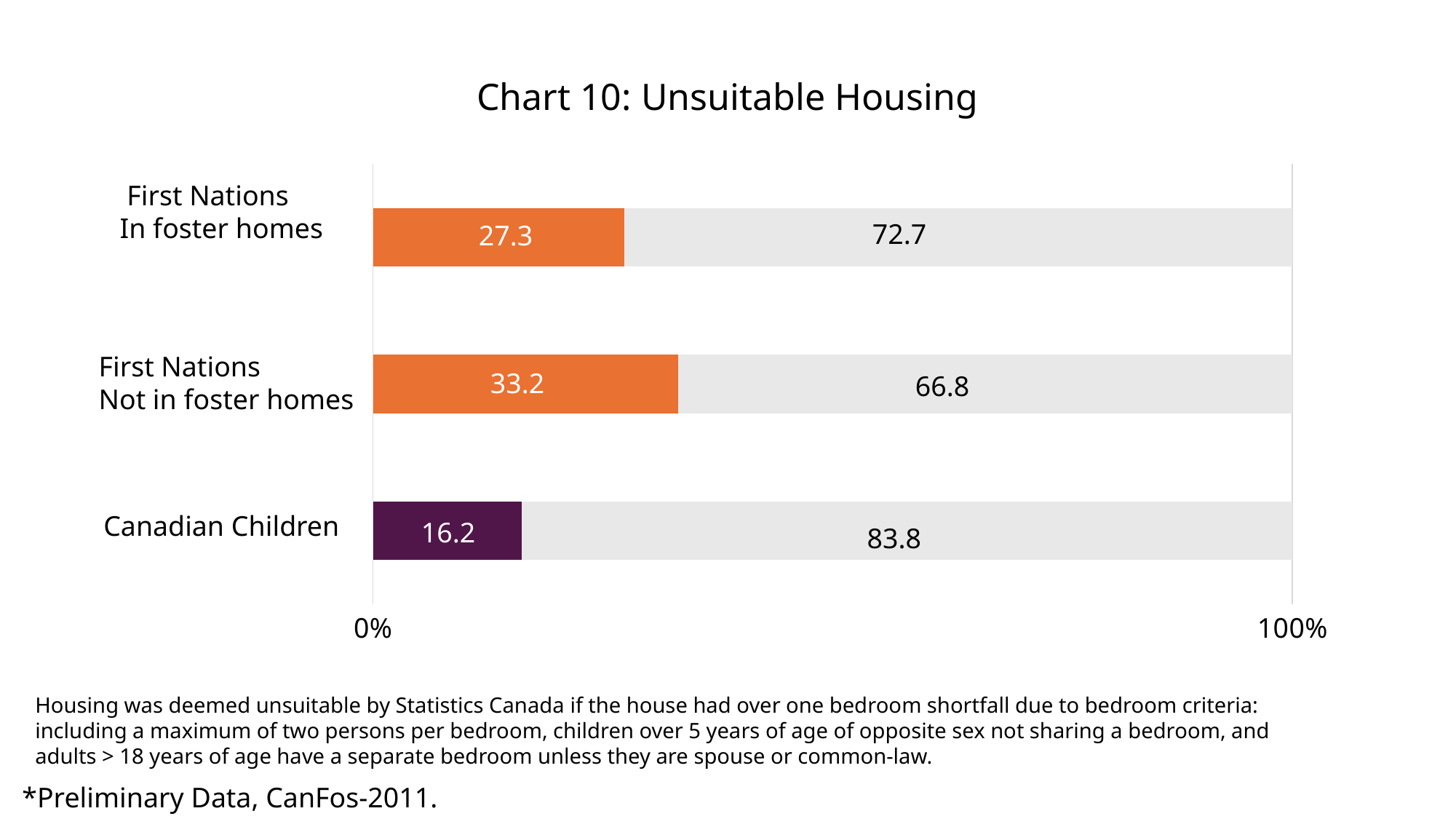
What is the value of the grey segment for Canadian Children? 83.8 Which category has the lowest unsuitable housing (coloured segment) value? Canadian Children What is the value of the coloured (unsuitable housing) segment for Canadian Children? 16.2 What is the total of the two segments in the First Nations In foster homes bar? 100 What is the difference between the unsuitable housing values for First Nations Not in foster homes and First Nations In foster homes? 5.9 What is the title of the chart? Chart 10: Unsuitable Housing Which category has the highest unsuitable housing (coloured segment) value? First Nations Not in foster homes What is the value of the coloured (unsuitable housing) segment for First Nations Not in foster homes? 33.2 How many categories are shown on the chart? 3 Which is larger: the unsuitable housing value for First Nations In foster homes or for Canadian Children? First Nations In foster homes What is the value of the coloured (unsuitable housing) segment for First Nations In foster homes? 27.3 What kind of chart is shown on the slide? Stacked bar chart